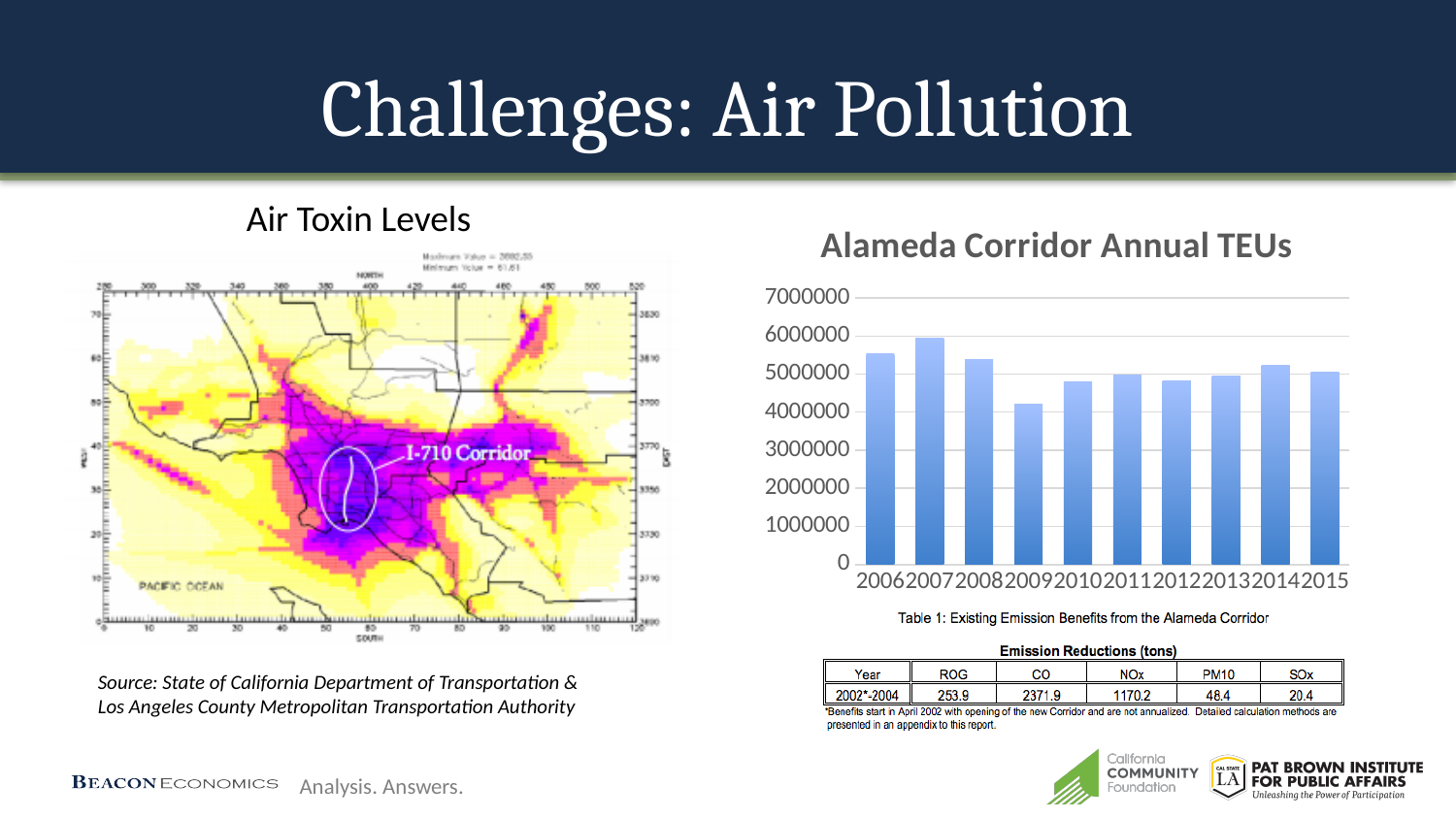
In the Alameda Corridor Annual TEUs chart, which year has the larger value, 2007 or 2009? 2007 In the Alameda Corridor Annual TEUs chart, is the value for 2009 greater or less than 5000000? less In the Alameda Corridor Annual TEUs chart, do the values rise or fall from 2007 to 2009? fall How many years are shown in the Alameda Corridor Annual TEUs chart? 10 What kind of chart is the Alameda Corridor Annual TEUs chart? bar chart In the Alameda Corridor Annual TEUs chart, is the value for 2006 greater or less than 5000000? greater What is the title of the bar chart on the right side of the slide? Alameda Corridor Annual TEUs In the Alameda Corridor Annual TEUs chart, which year has the highest value? 2007 In the Alameda Corridor Annual TEUs chart, which year has the lowest value? 2009 In the Alameda Corridor Annual TEUs chart, is the value for 2007 greater or less than 5000000? greater